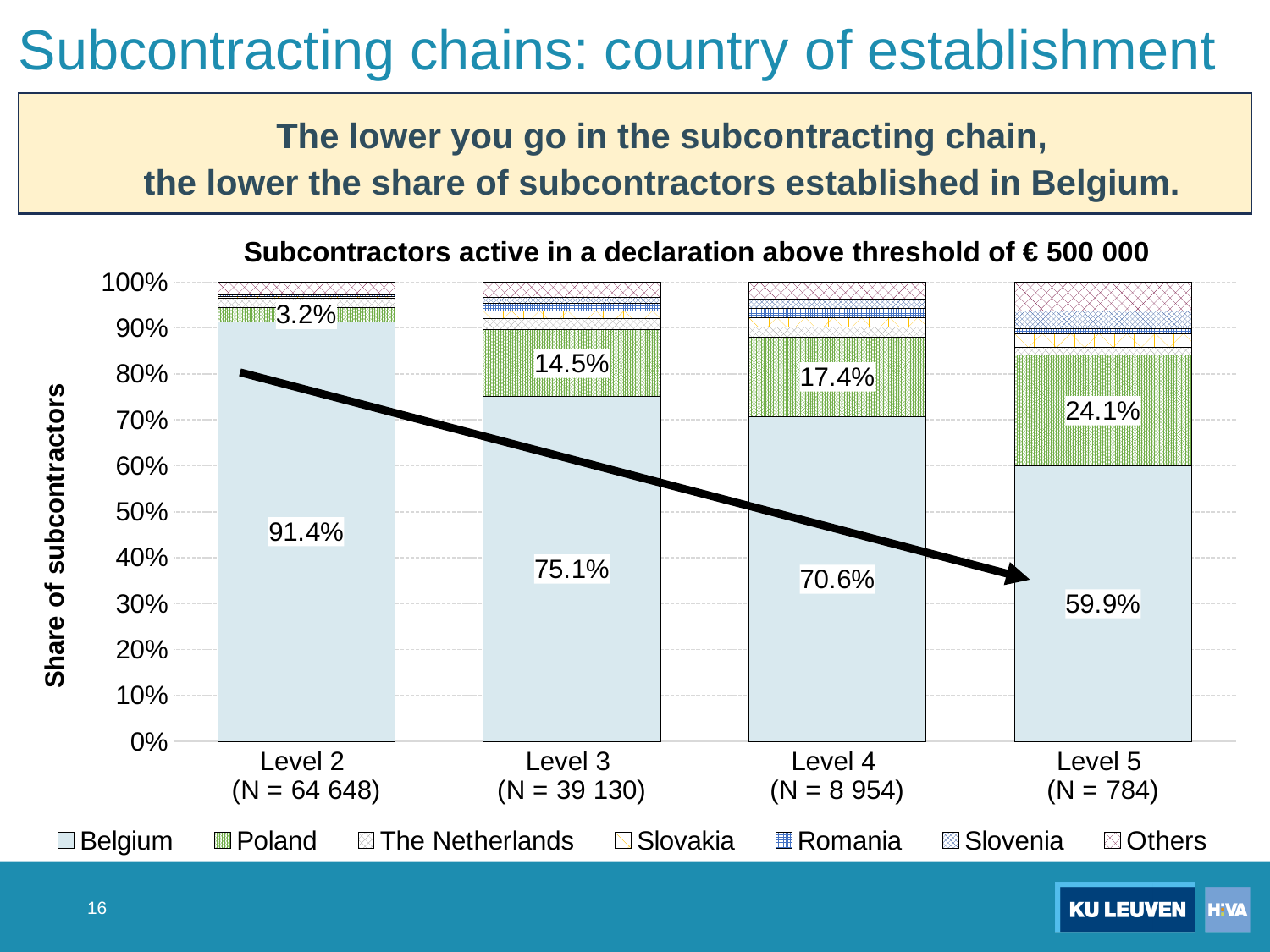
At which level is the share of subcontractors established in Belgium the lowest? Level 5 How many countries/series does the legend list? 7 Which is larger: the Poland share at Level 4 or at Level 3? Level 4 What is the share of subcontractors established in Belgium at Level 2? 91.4% What type of chart is shown on the slide? Stacked bar chart What is the share of subcontractors established in Poland at Level 3? 14.5% What is the share of subcontractors established in Poland at Level 5? 24.1% What is the share of subcontractors established in Belgium at Level 4? 70.6% How does the share of subcontractors established in Belgium change from Level 2 to Level 5? It falls What is the difference between the Belgium share at Level 2 and at Level 5? 31.5% How many levels (categories) are shown on the x axis? 4 At which level is the share of subcontractors established in Poland the highest? Level 5